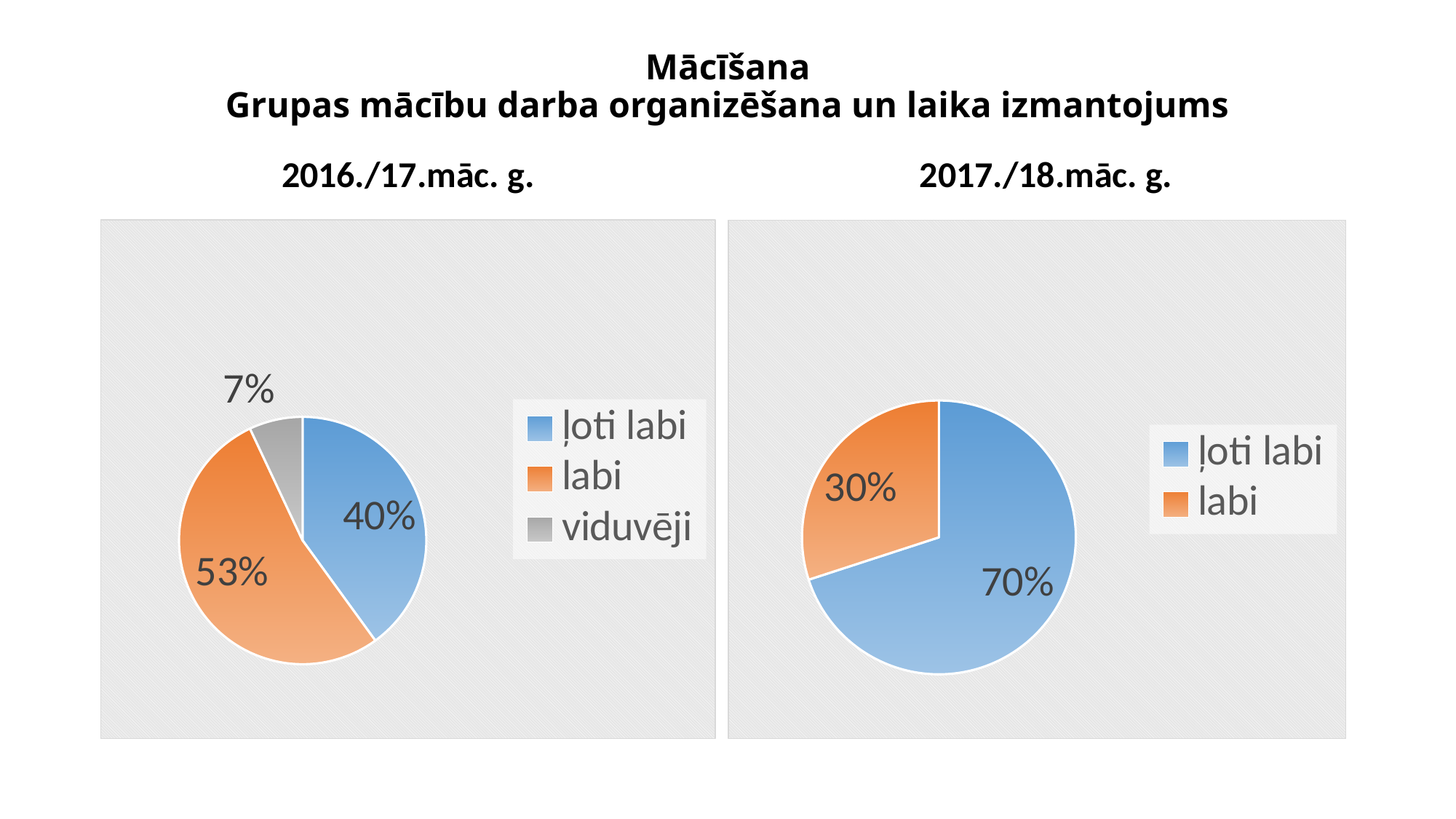
In the 2017./18.māc. g. pie chart, which category has the largest share? ļoti labi In the 2016./17.māc. g. pie chart, which category has the largest share? labi What type of chart is used for the 2017./18.māc. g. data? Pie chart In the 2016./17.māc. g. pie chart, what is the difference between the shares of "labi" and "ļoti labi"? 13% How many entries does the legend of the 2017./18.māc. g. chart list? 2 In the 2016./17.māc. g. pie chart, which category has the smallest share? viduvēji In the 2016./17.māc. g. pie chart, what share does "labi" have? 53% In the 2016./17.māc. g. pie chart, what share does "viduvēji" have? 7% How many categories does the 2016./17.māc. g. pie chart show? 3 In the 2017./18.māc. g. pie chart, what share does "labi" have? 30% In the 2017./18.māc. g. pie chart, what share does "ļoti labi" have? 70% In the 2017./18.māc. g. pie chart, what is the difference between the shares of "ļoti labi" and "labi"? 40%